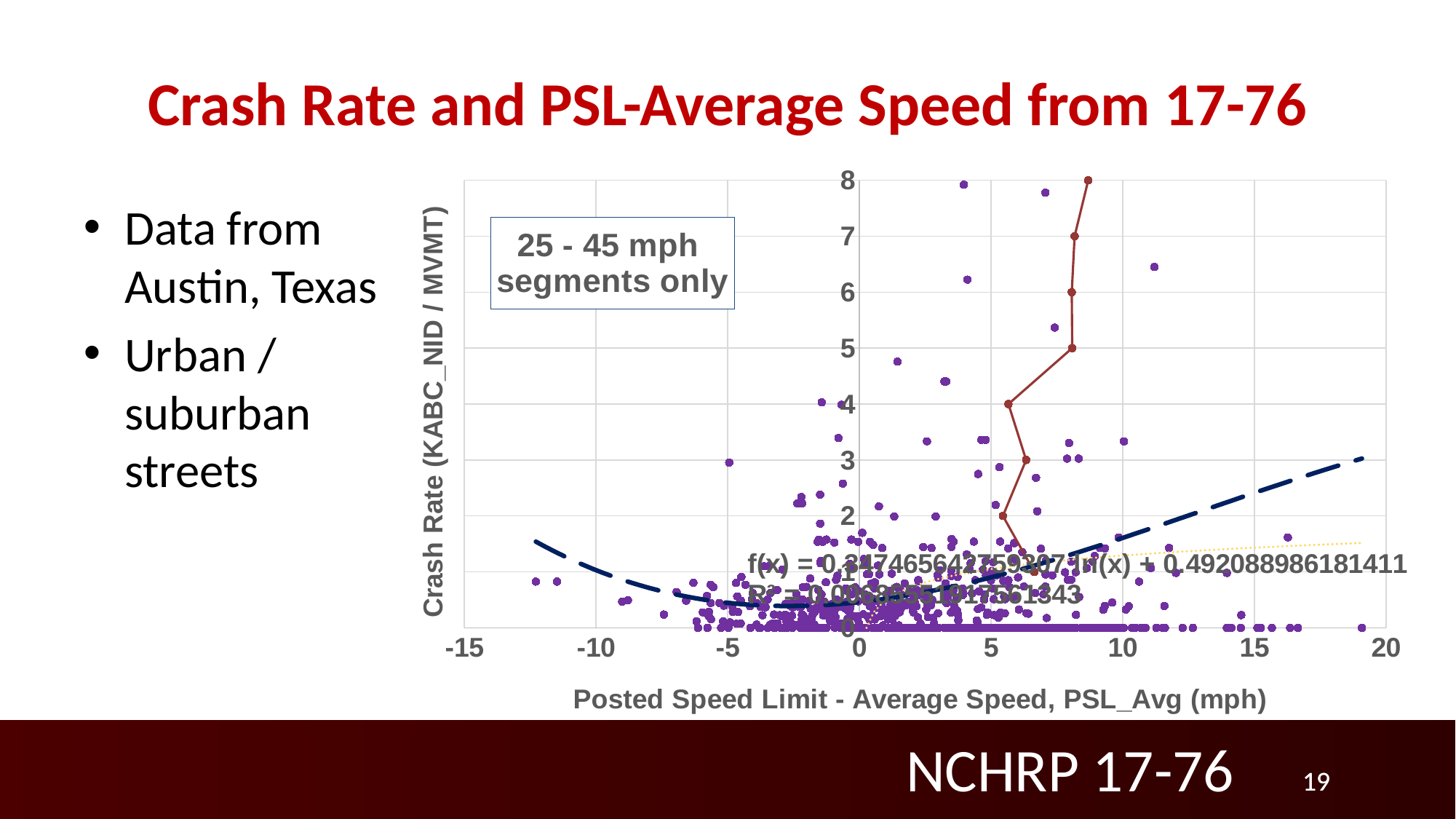
What is the title of the x axis of the chart? Posted Speed Limit - Average Speed, PSL_Avg (mph) What does the text box inside the chart say? 25 - 45 mph segments only Is the value of the dashed trend line at a PSL_Avg of 0 mph greater or less than 1? less Does the dashed trend line rise or fall as PSL_Avg increases from -15 to 0 mph? fall What kind of chart is shown on the slide? scatter chart Is the PSL_Avg value of the red line at a crash rate of 8 greater or less than 5? greater Is the dashed trend line higher at a PSL_Avg of 20 mph or at 0 mph? 20 mph Is the value of the dashed trend line at a PSL_Avg of 20 mph greater or less than 2? greater Does the dashed trend line rise or fall as PSL_Avg increases from 10 to 20 mph? rise